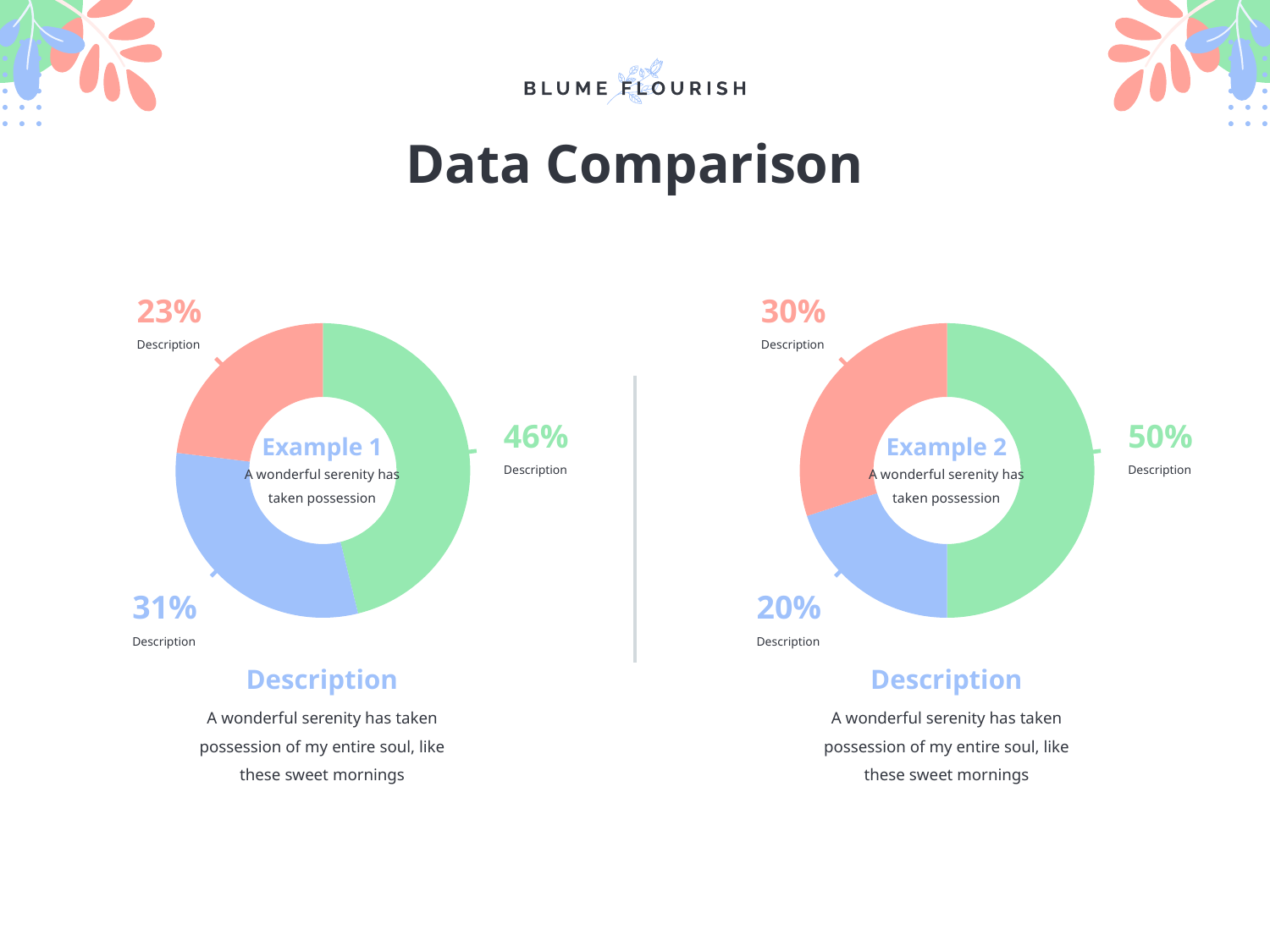
In the Example 1 chart, what percentage is shown for the green slice? 46% Which is larger: the pink slice in the Example 1 chart or the pink slice in the Example 2 chart? Example 2 How many slices does the Example 2 chart have? 3 In the Example 2 chart, what percentage is shown for the green slice? 50% In the Example 1 chart, what percentage is shown for the blue slice? 31% In the Example 2 chart, what is the difference between the pink slice and the blue slice? 10% In the Example 1 chart, which colour slice has the smallest share? Pink In the Example 2 chart, which colour slice has the largest share? Green What kind of chart is shown on the left side of the slide, labelled Example 1? Donut chart In the Example 1 chart, what percentage is shown for the pink slice? 23% In the Example 1 chart, what is the difference between the green slice and the blue slice? 15% In the Example 2 chart, what percentage is shown for the blue slice? 20%